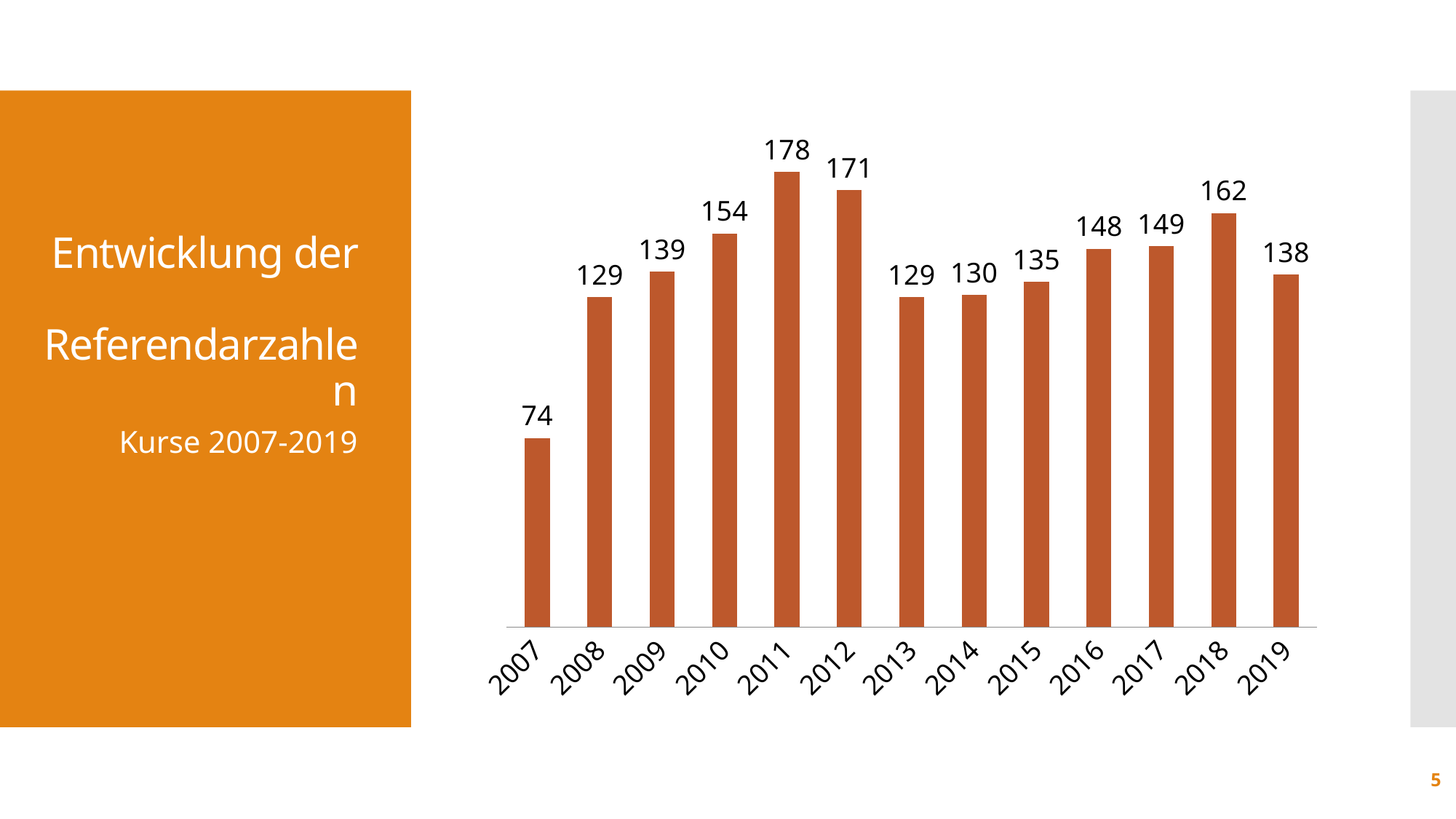
What is the subtitle shown below the slide title? Kurse 2007-2019 What is the value for 2007? 74 How many years are shown on the x axis? 13 Which is larger, the value for 2010 or the value for 2016? 2010 What kind of chart is shown on the slide? bar chart What is the difference between the values for 2018 and 2019? 24 What is the value for 2011? 178 What is the difference between the values for 2011 and 2012? 7 Which year has the highest value? 2011 Which year has the lowest value? 2007 What is the value for 2018? 162 Do the values rise or fall from 2007 to 2011? rise